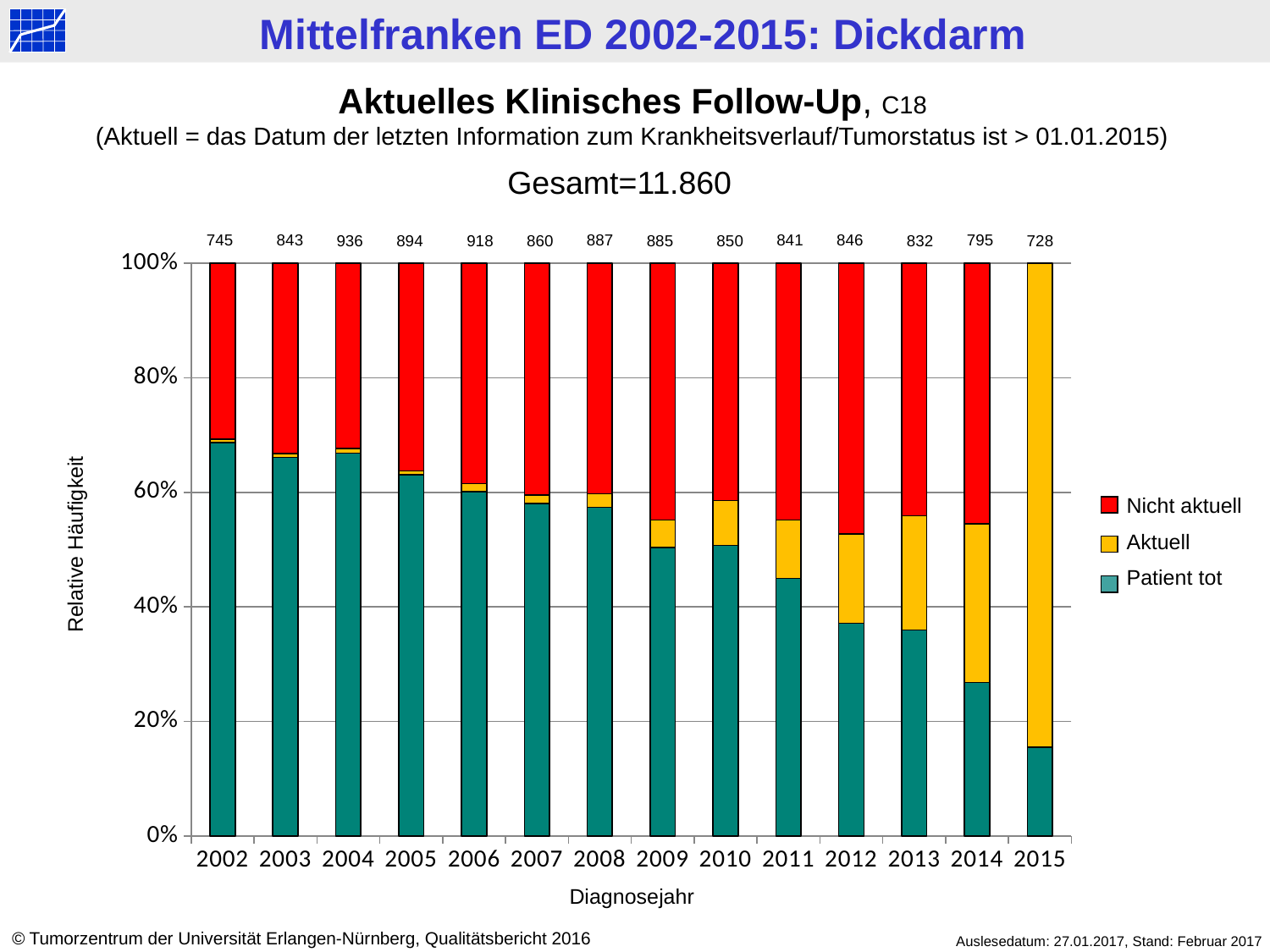
Does the 'Patient tot' share rise or fall from 2002 to 2015? fall How many diagnosis years are shown on the x axis? 14 Which diagnosis year has the highest number printed above its bar? 2004 Which diagnosis year has the lowest number printed above its bar? 2015 What is the number printed above the bar for 2004? 936 Is the 'Patient tot' share for 2002 greater or less than 60%? greater Which has the larger number printed above its bar, 2006 or 2014? 2006 What is the difference between the numbers printed above the bars for 2004 and 2015? 208 What kind of chart is shown on the slide? Stacked bar chart What is the label of the x axis? Diagnosejahr What is the number printed above the bar for 2015? 728 How many series does the legend list? 3